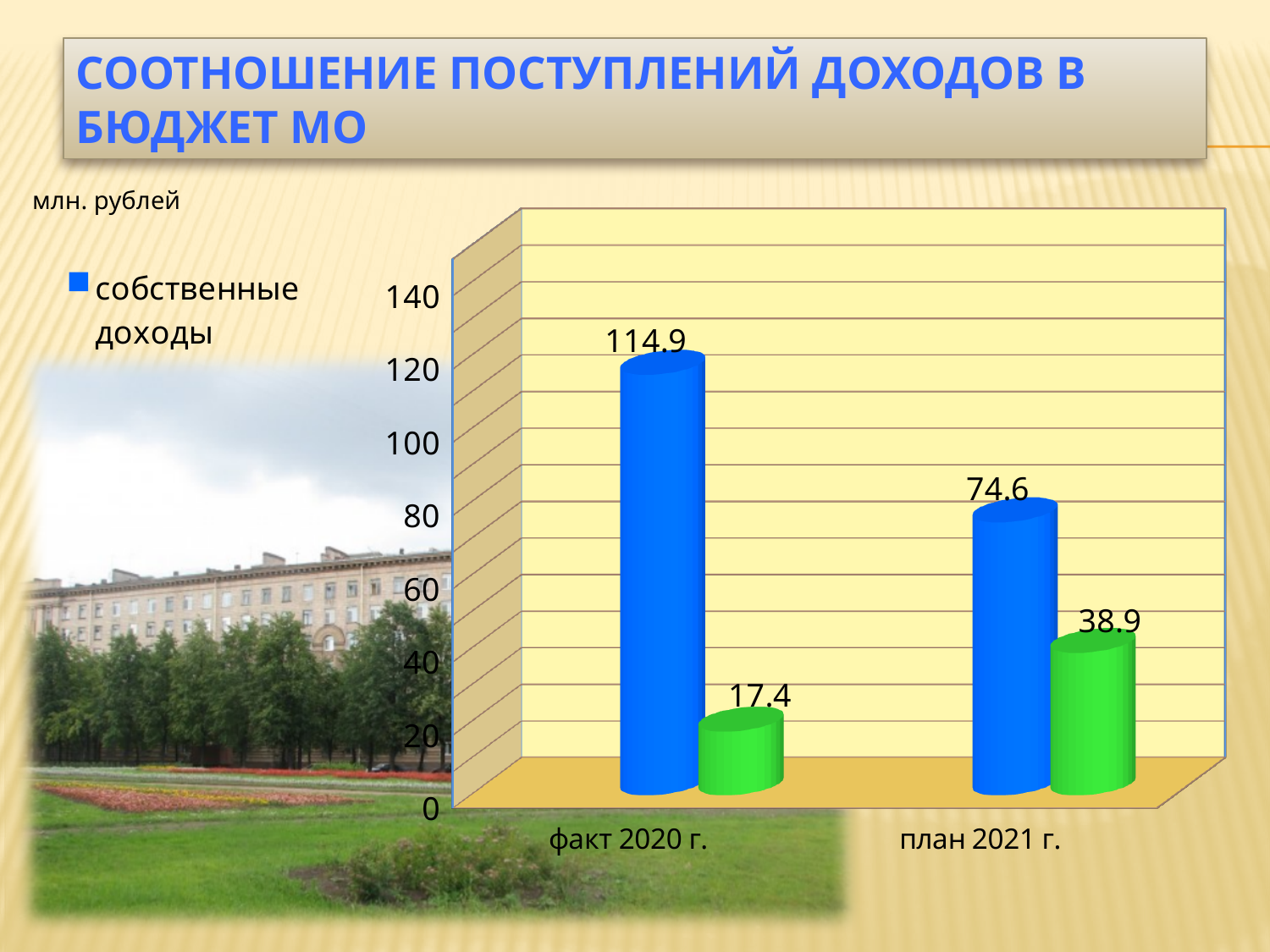
What is the value of the green bar for план 2021 г.? 38.9 What is the value of собственные доходы for план 2021 г.? 74.6 What is the value of собственные доходы for факт 2020 г.? 114.9 Which category has the lower value for the green series? факт 2020 г. By how much does собственные доходы for факт 2020 г. exceed that for план 2021 г.? 40.3 What is the value of the green bar for факт 2020 г.? 17.4 What is the difference between the green bar values for план 2021 г. and факт 2020 г.? 21.5 What unit is stated for the chart values? млн. рублей Does собственные доходы rise or fall from факт 2020 г. to план 2021 г.? fall How many categories are shown on the x axis? 2 Which category has the higher value for собственные доходы? факт 2020 г. For факт 2020 г., which is larger: собственные доходы or the green series? собственные доходы